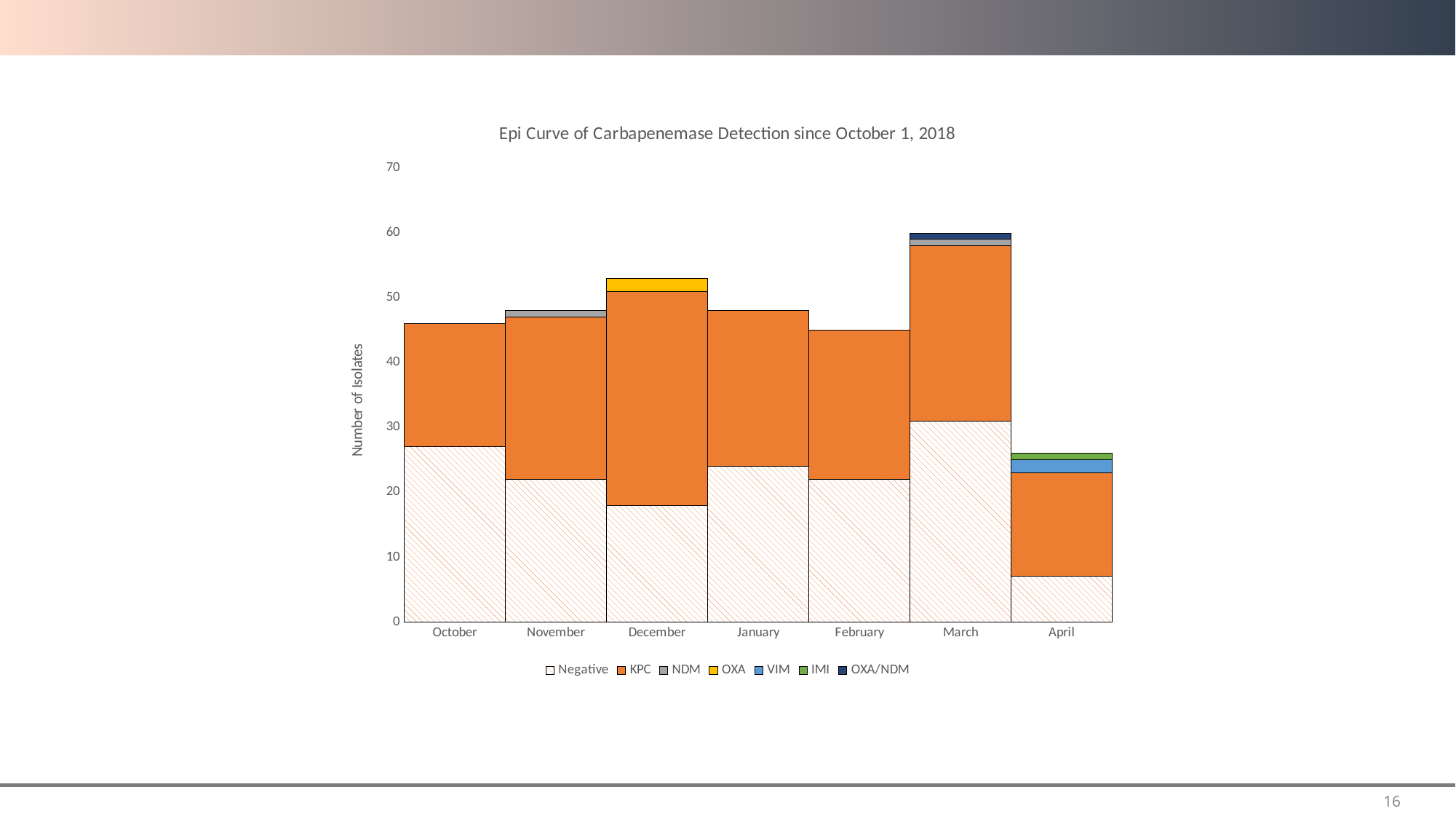
What is the label on the y axis of the chart? Number of Isolates Which month has the lowest total number of isolates? April Is the total number of isolates for October greater or less than 50? less Is the Negative value for April greater or less than 10? less How many series does the chart's legend list? 7 Which month has the larger Negative segment, October or December? October Is the total number of isolates for April greater or less than 30? less What is the title of the chart? Epi Curve of Carbapenemase Detection since October 1, 2018 What kind of chart is shown on the slide? Stacked bar chart Which month has the highest total number of isolates? March How many months are shown on the x axis of the chart? 7